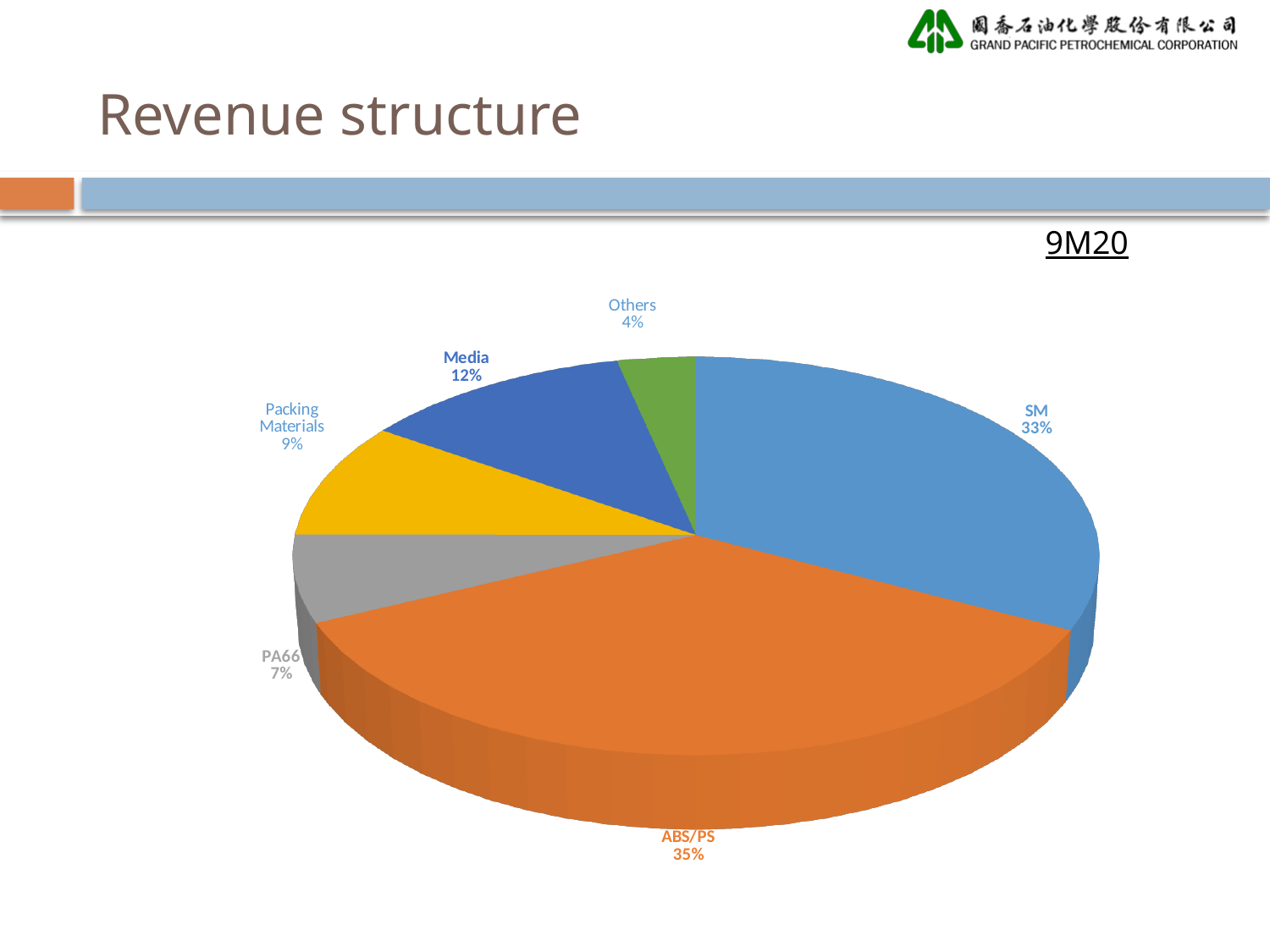
How many categories are shown in the pie chart? 6 What is the difference in percentage points between the ABS/PS share and the SM share? 2% Which category has the largest share of revenue? ABS/PS What percentage of revenue comes from ABS/PS? 35% Which period does the revenue structure chart cover? 9M20 What type of chart is used to show the revenue structure? Pie chart What percentage does PA66 contribute to revenue? 7% What is the share for Media in the revenue structure chart? 12% What share of revenue is attributed to Packing Materials? 9% What share of revenue does SM account for in the 9M20 pie chart? 33% Which has a larger share of revenue, Media or Packing Materials? Media Which category has the smallest share of revenue? Others